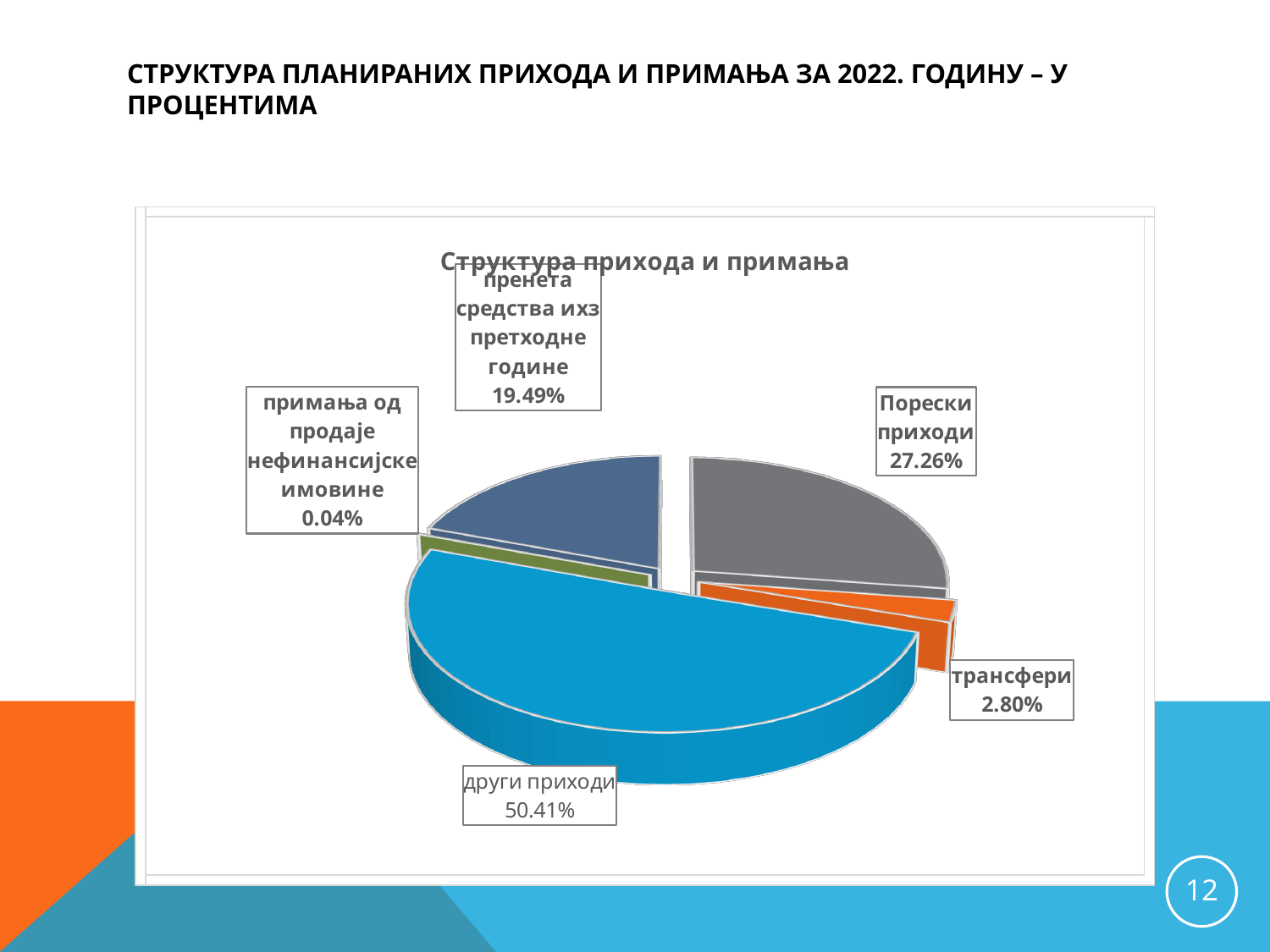
What share of the pie is 'други приходи'? 50.41% How many slices does the pie chart have? 5 Which is larger, the share for 'Порески приходи' or the share for 'трансфери'? Порески приходи What is the difference in percentage points between 'Порески приходи' and 'пренета средства из претходне године'? 7.77 Which category has the smallest share of the pie? примања од продаје нефинансијске имовине What is the chart's title? Структура прихода и примања What share of the pie is 'Порески приходи'? 27.26% What share of the pie is 'пренета средства из претходне године'? 19.49% What kind of chart is shown on the slide? pie chart Which category has the largest share of the pie? други приходи